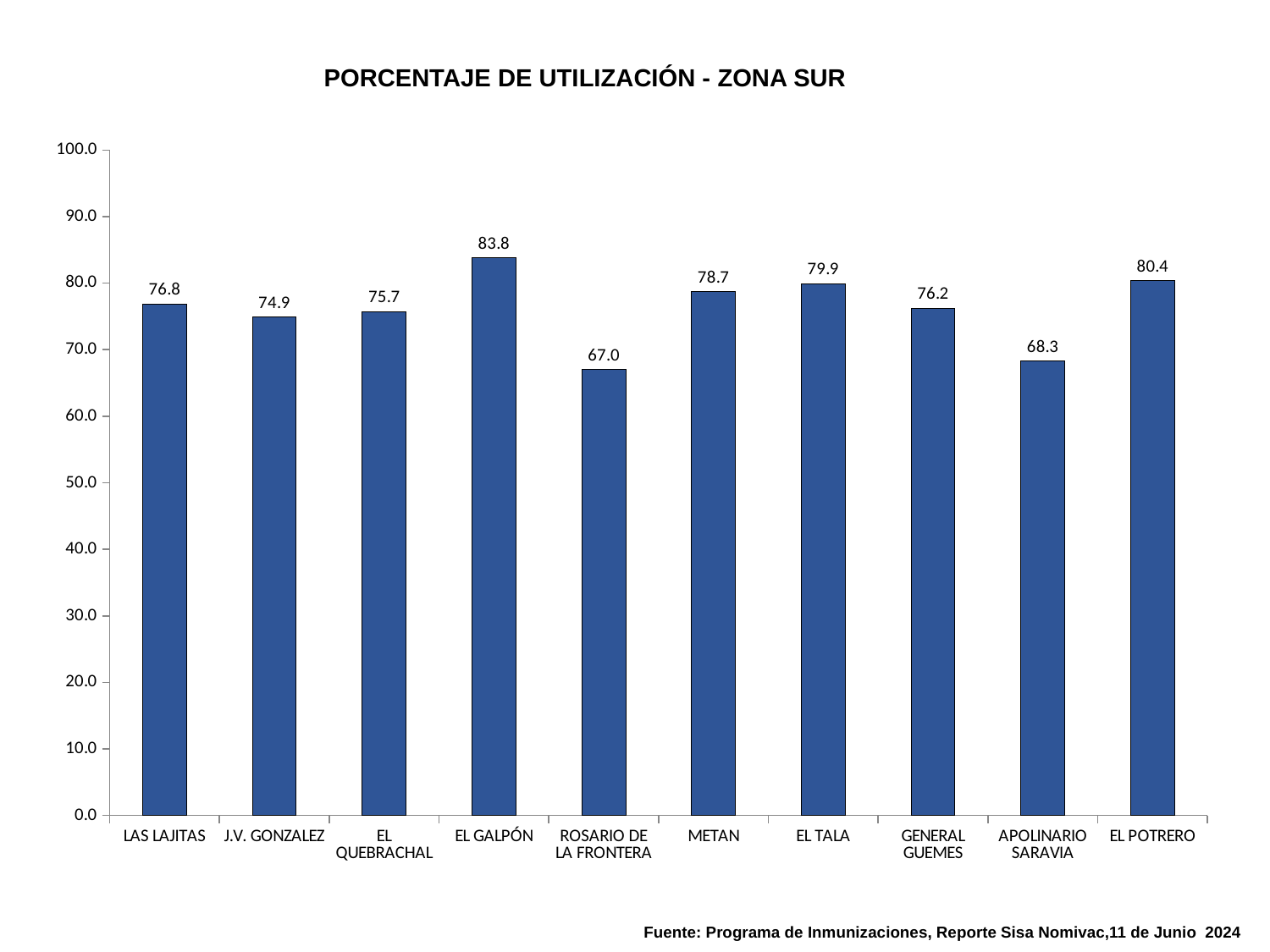
Which category has the lowest value? ROSARIO DE LA FRONTERA How many categories are shown on the x axis? 10 What is the difference between the values for EL GALPÓN and ROSARIO DE LA FRONTERA? 16.8 Which is larger, the value for EL TALA or the value for GENERAL GUEMES? EL TALA What is the value for ROSARIO DE LA FRONTERA? 67.0 What kind of chart is shown on the slide? bar chart What is the value for EL GALPÓN? 83.8 What is the value for METAN? 78.7 What is the title of the chart? PORCENTAJE DE UTILIZACIÓN - ZONA SUR Which category has the highest value? EL GALPÓN Is the value for APOLINARIO SARAVIA greater or less than 70.0? less What is the difference between the values for EL POTRERO and APOLINARIO SARAVIA? 12.1